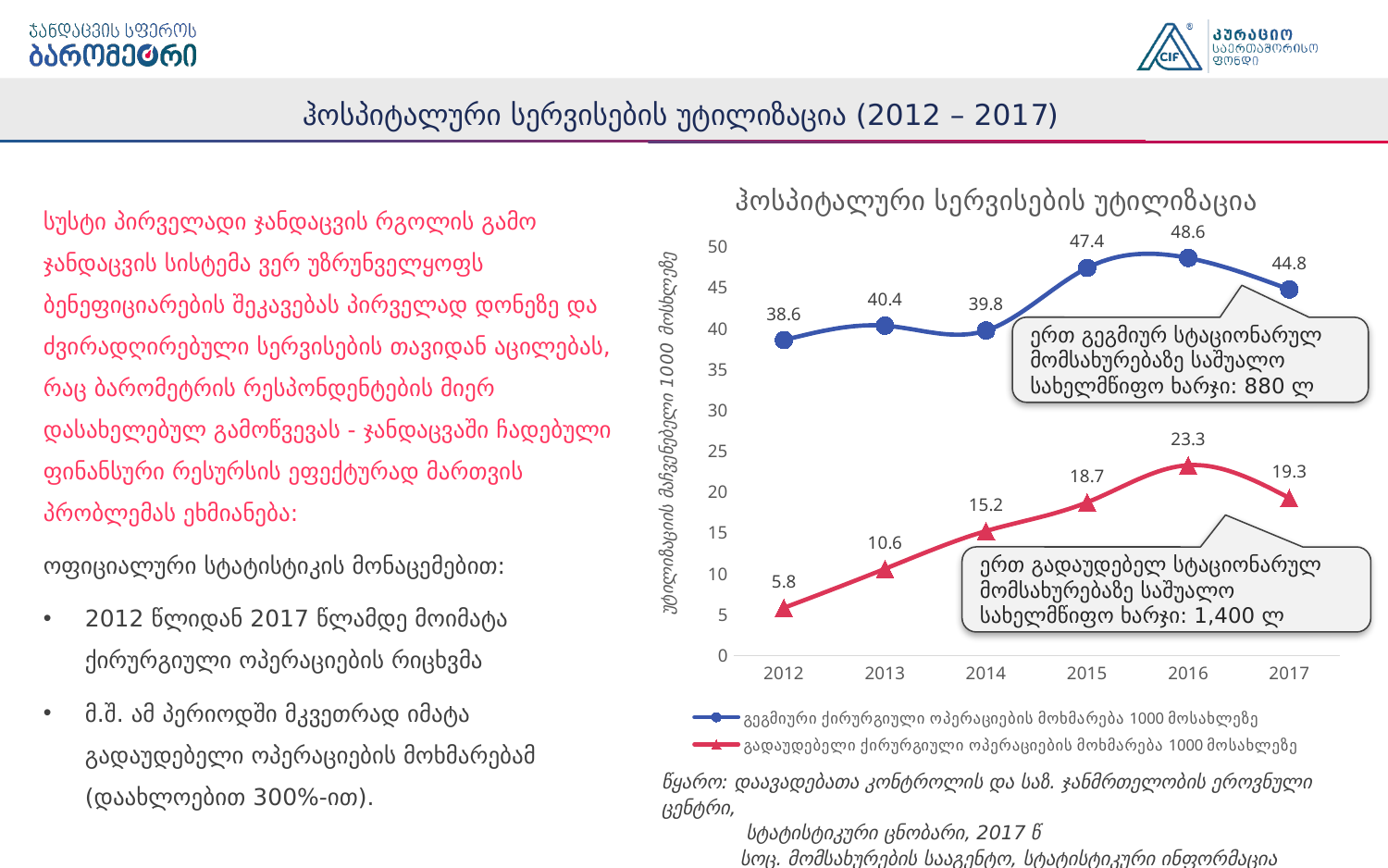
What is the difference between the blue line value and the red line value in 2015? 28.7 In which year does the blue line (planned surgical operations) reach its highest value? 2016 What is the value of the red line (გადაუდებელი ქირურგიული ოპერაციების მოხმარება 1000 მოსახლეზე) in 2016? 23.3 In which year does the red line (emergency surgical operations) have its lowest value? 2012 Which is larger in 2014: the blue line value or the red line value? the blue line (39.8) What type of chart is shown on the slide? line chart What is the value of the blue line (planned surgical operations) in 2017? 44.8 How many years are plotted along the x axis of the chart? 6 What is the title of the chart? ჰოსპიტალური სერვისების უტილიზაცია Does the red line (emergency surgical operations) generally rise or fall from 2012 to 2016? rise What is the value of the blue line (გეგმიური ქირურგიული ოპერაციების მოხმარება 1000 მოსახლეზე) in 2012? 38.6 How many series does the chart legend list? 2